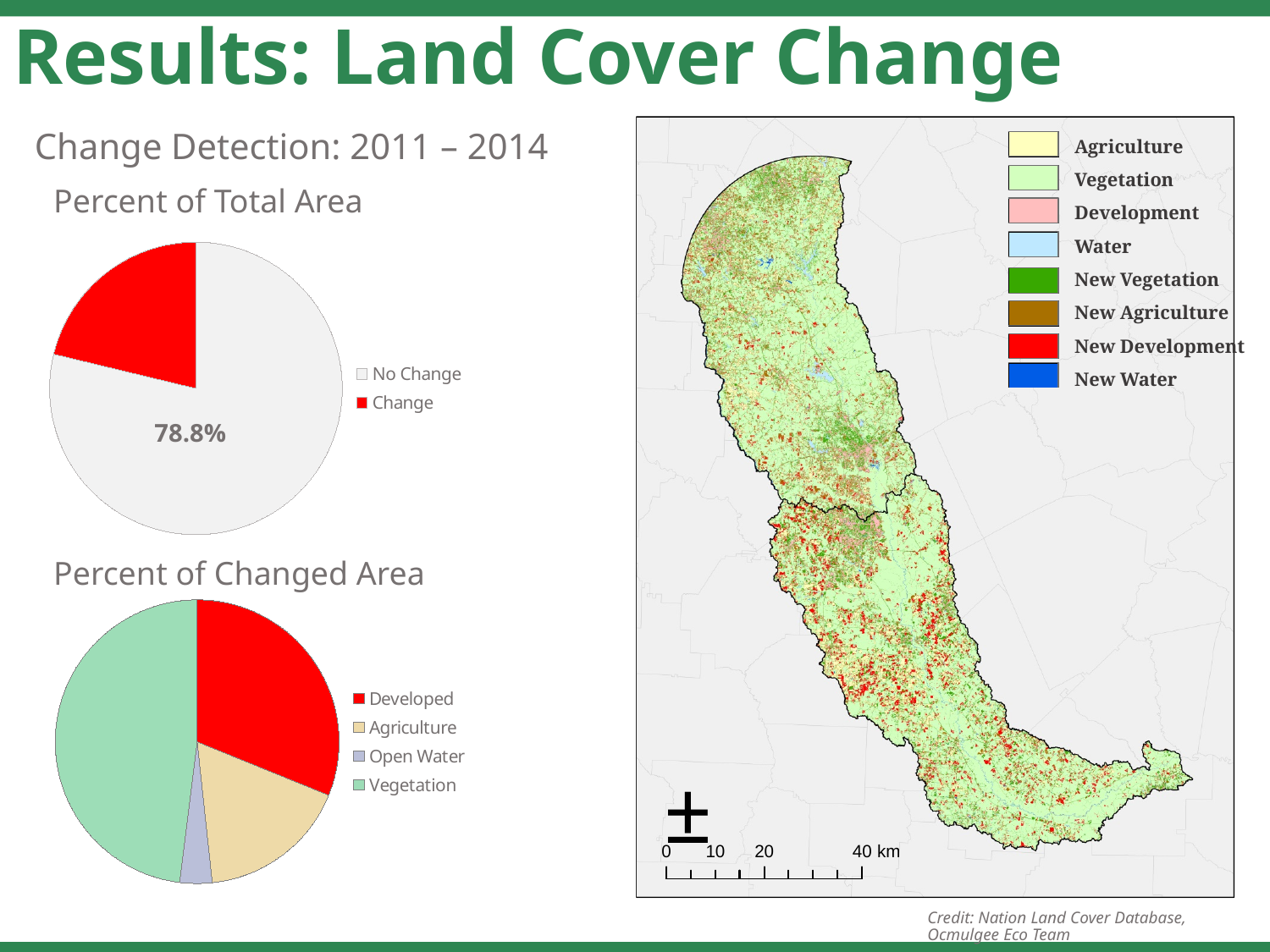
In the "Percent of Changed Area" chart, which category has the smallest slice? Open Water In the "Percent of Changed Area" chart, which category has the largest slice? Vegetation In the "Percent of Total Area" chart, what percentage is shown for No Change? 78.8% What is the title of the lower pie chart on the slide? Percent of Changed Area In the "Percent of Total Area" chart, which category has the largest slice? No Change In the "Percent of Changed Area" chart, which slice is larger: Vegetation or Developed? Vegetation In the "Percent of Changed Area" chart, what colour is the Developed slice? red What kind of chart is the "Percent of Total Area" chart? pie chart In the "Percent of Changed Area" chart, which slice is larger: Developed or Agriculture? Developed What kind of chart is the "Percent of Changed Area" chart? pie chart How many categories does the legend of the "Percent of Total Area" chart list? 2 How many categories does the "Percent of Changed Area" chart have? 4